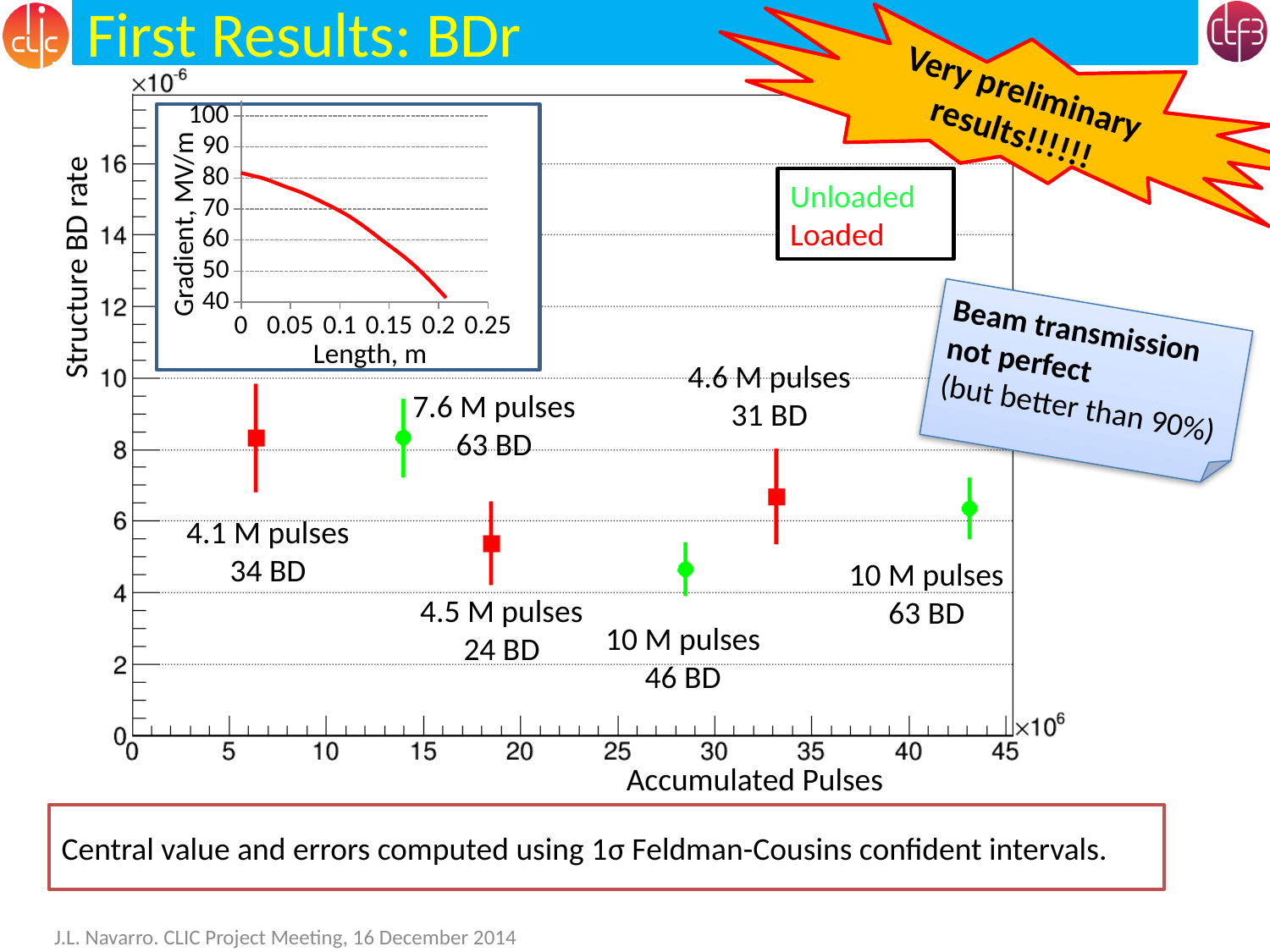
What kind of chart is the inset chart of Gradient vs Length? Line chart How many data points are plotted in the main chart? 6 In the main chart, how many BD are reported for the point labelled 7.6 M pulses? 63 BD In the main chart, how many BD are reported for the point labelled 4.5 M pulses? 24 BD In the main chart, which Loaded point has the higher Structure BD rate: the one near 6 million accumulated pulses or the one near 18 million? The one near 6 million What kind of chart is the main chart (Structure BD rate vs Accumulated Pulses)? Scatter chart with error bars In the main chart, is the Structure BD rate of the Unloaded point near 28 million accumulated pulses greater or less than 6? less What colour is used for the Loaded series in the main chart? Red How many series does the legend of the main chart list? 2 In the main chart, is the Structure BD rate of the Loaded point near 33 million accumulated pulses greater or less than 6? greater In the inset chart, does the Gradient rise or fall as Length increases? Fall What are the two series named in the legend of the main chart? Unloaded and Loaded